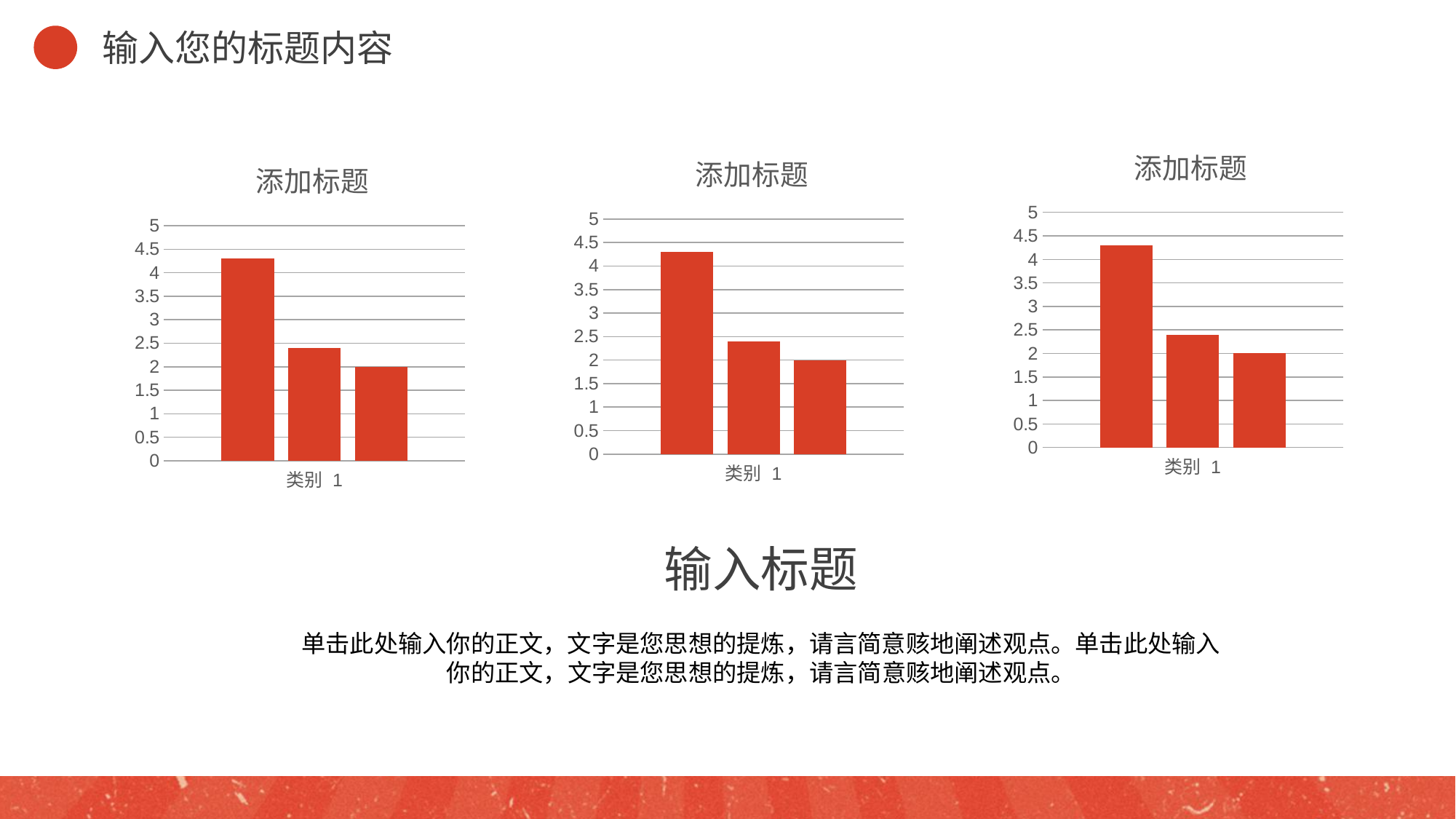
In the right chart, which is larger, the first bar or the second bar? the first bar In the middle chart, which bar is the shortest: the first, second or third? the third What kind of chart is the left chart on the slide? bar chart How many bars are plotted in the right chart? 3 In the middle chart, is the value of the middle bar greater or less than 3? less In the left chart, which bar is the tallest: the first, second or third? the first What is the category label on the x axis of the right chart? 类别 1 In the left chart, is the value of the tallest bar greater or less than 4? greater How many categories are shown on the x axis of the middle chart? 1 What is the highest value shown on the y axis of the middle chart? 5 What is the title of the left chart? 添加标题 In the right chart, is the value of the first (leftmost) bar greater or less than 4.5? less